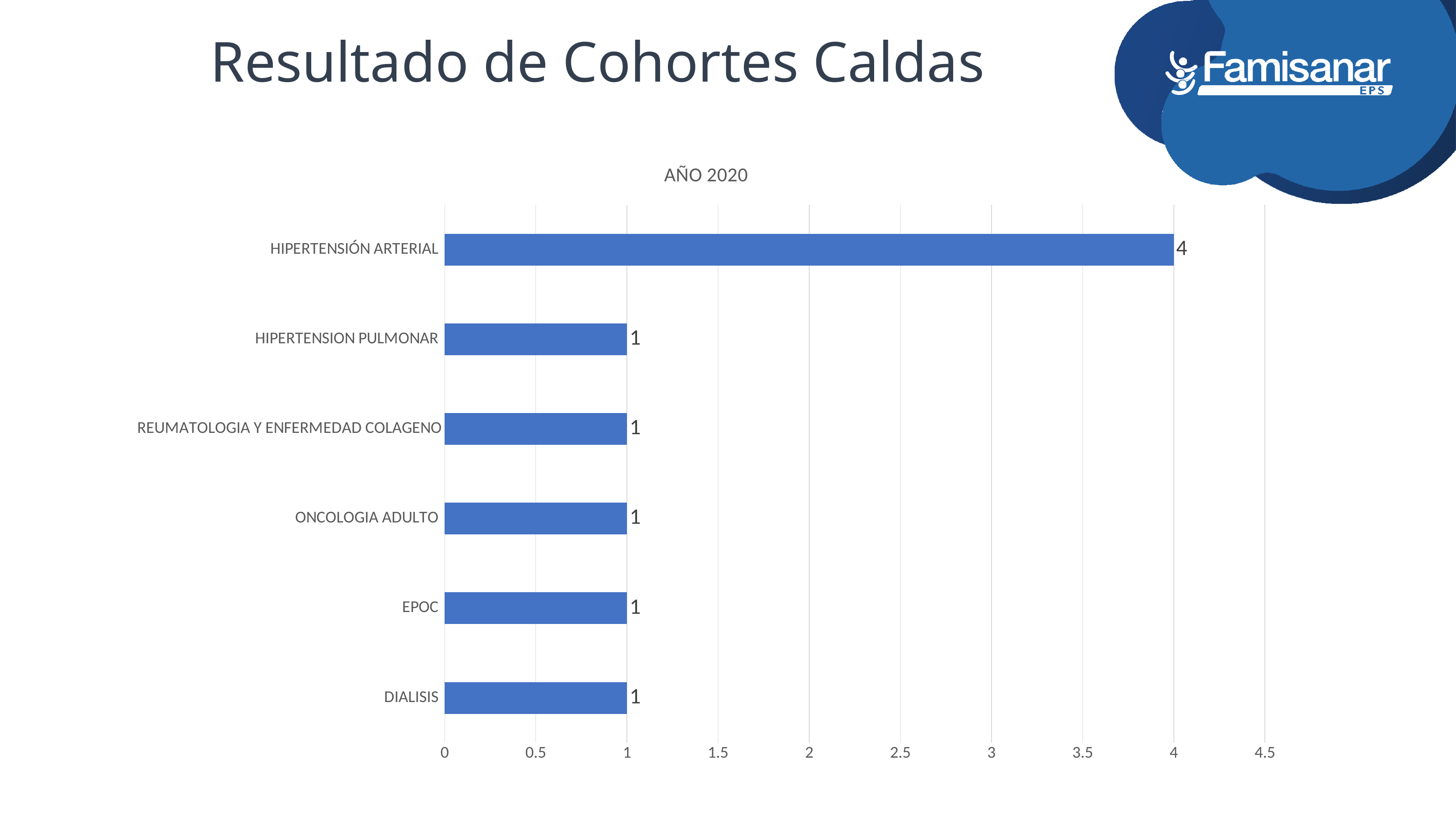
What is the value for EPOC? 1 Which category has the highest value? HIPERTENSIÓN ARTERIAL What kind of chart is shown on the slide? bar chart How many categories are shown in the chart? 6 Is the value for HIPERTENSIÓN ARTERIAL greater or less than 3? greater What is the value for HIPERTENSION PULMONAR? 1 What is the title of the chart? AÑO 2020 What is the value for HIPERTENSIÓN ARTERIAL? 4 What is the value for DIALISIS? 1 What is the highest value shown on the x axis? 4.5 What is the difference between the values for HIPERTENSIÓN ARTERIAL and ONCOLOGIA ADULTO? 3 Which is larger, the value for HIPERTENSIÓN ARTERIAL or the value for REUMATOLOGIA Y ENFERMEDAD COLAGENO? HIPERTENSIÓN ARTERIAL